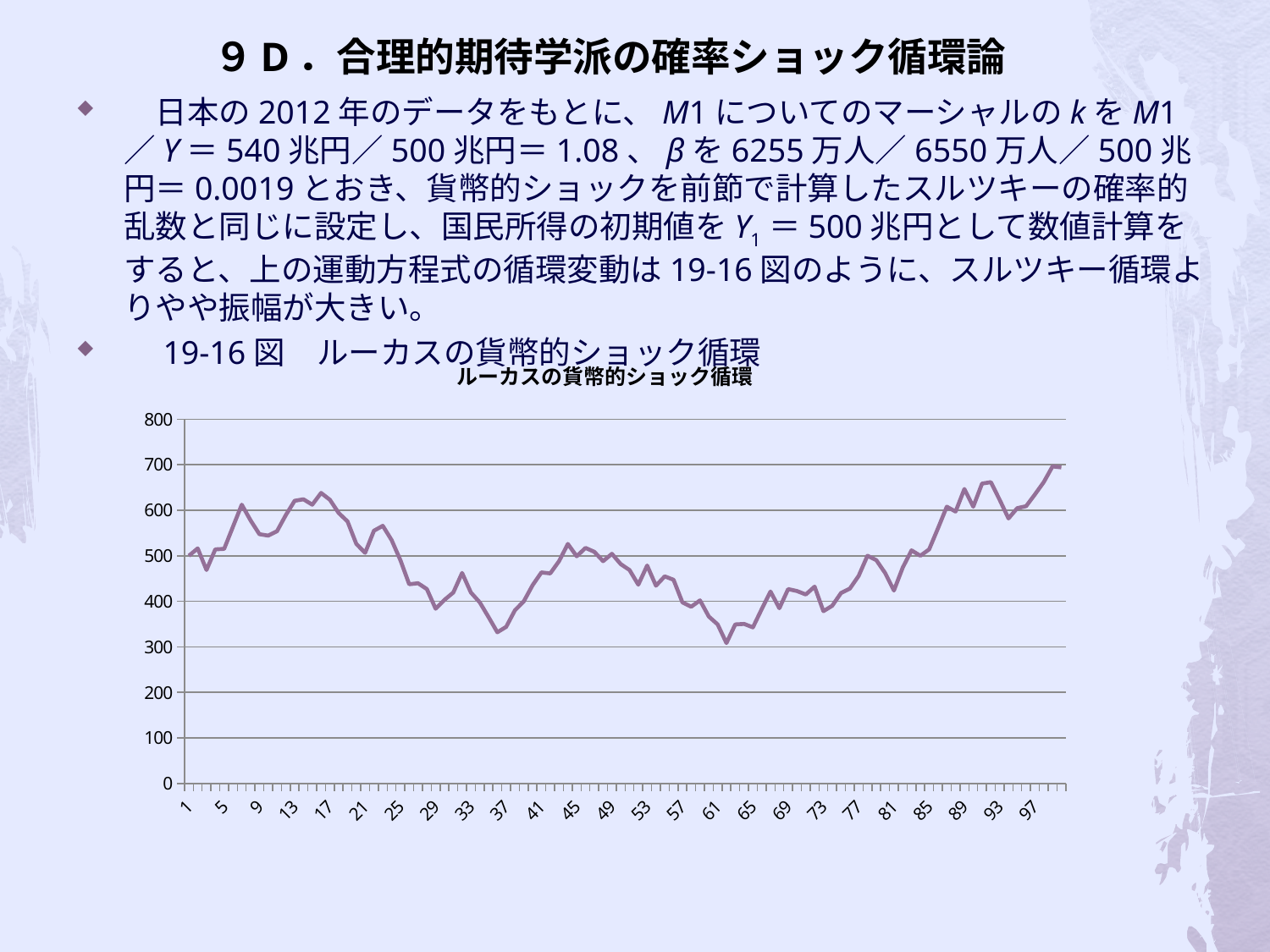
Is the value at x = 89 greater or less than 500? greater Is the value at x = 61 greater or less than 500? less Comparing the start of the series (x = 1) with the end (x = 97 and beyond), does the line end higher or lower than it starts? higher What kind of chart is shown on the slide? line chart How many lines (series) are plotted in the chart? 1 What is the highest value shown on the vertical axis of the chart? 800 Is the value at x = 29 greater or less than 500? less What is the title of the chart? ルーカスの貨幣的ショック循環